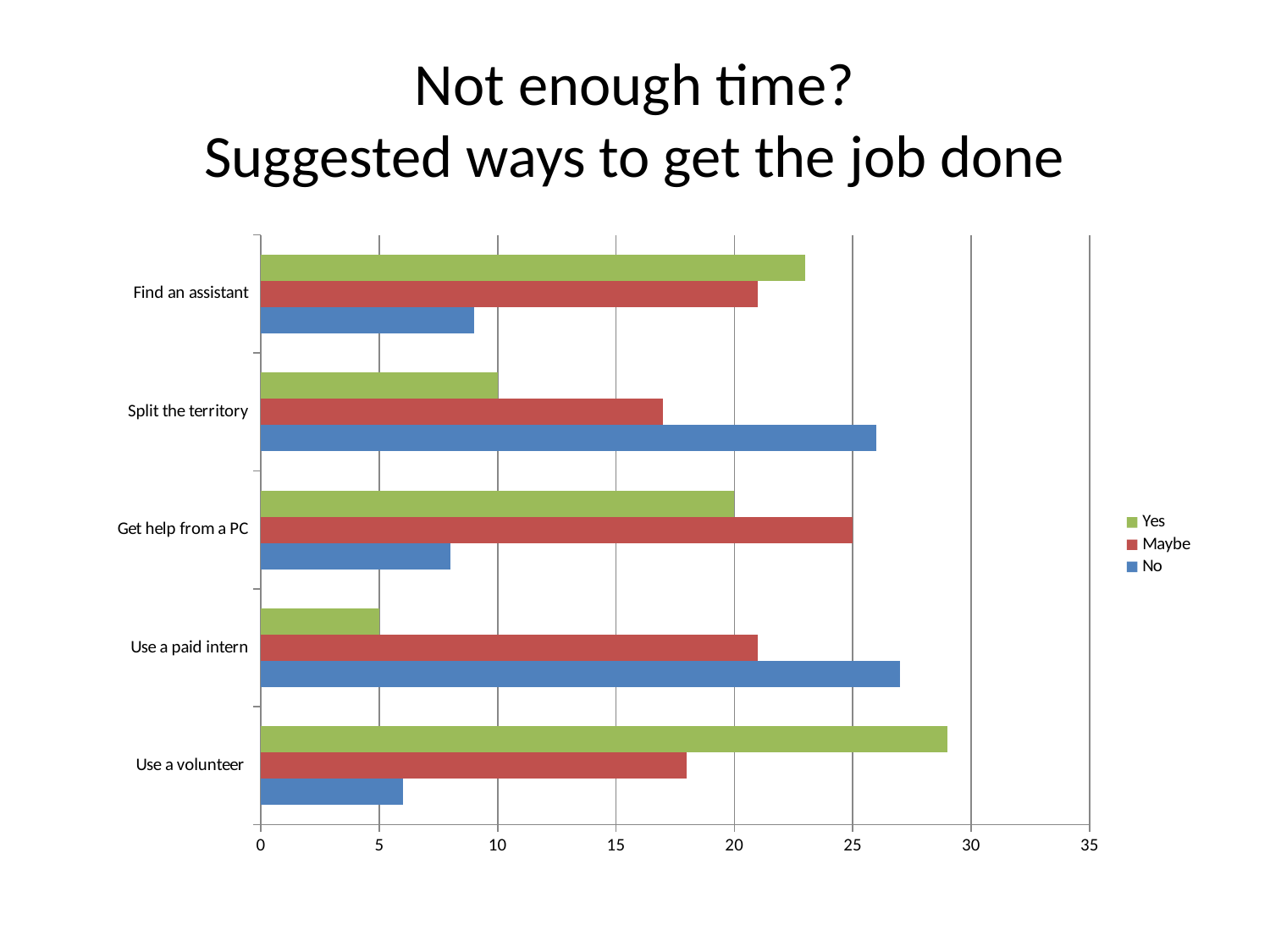
What is the Yes value for Get help from a PC? 20 Which category has the highest Yes value? Use a volunteer How many categories are shown on the chart? 5 How many series does the legend list? 3 For Find an assistant, which is larger, the Yes value or the No value? Yes What is the Maybe value for Get help from a PC? 25 Is the No value for Split the territory greater or less than 25? greater What is the Yes value for Use a paid intern? 5 What is the Yes value for Split the territory? 10 What kind of chart is shown on the slide? bar chart What is the difference between the Maybe and Yes values for Get help from a PC? 5 Which category has the lowest Yes value? Use a paid intern